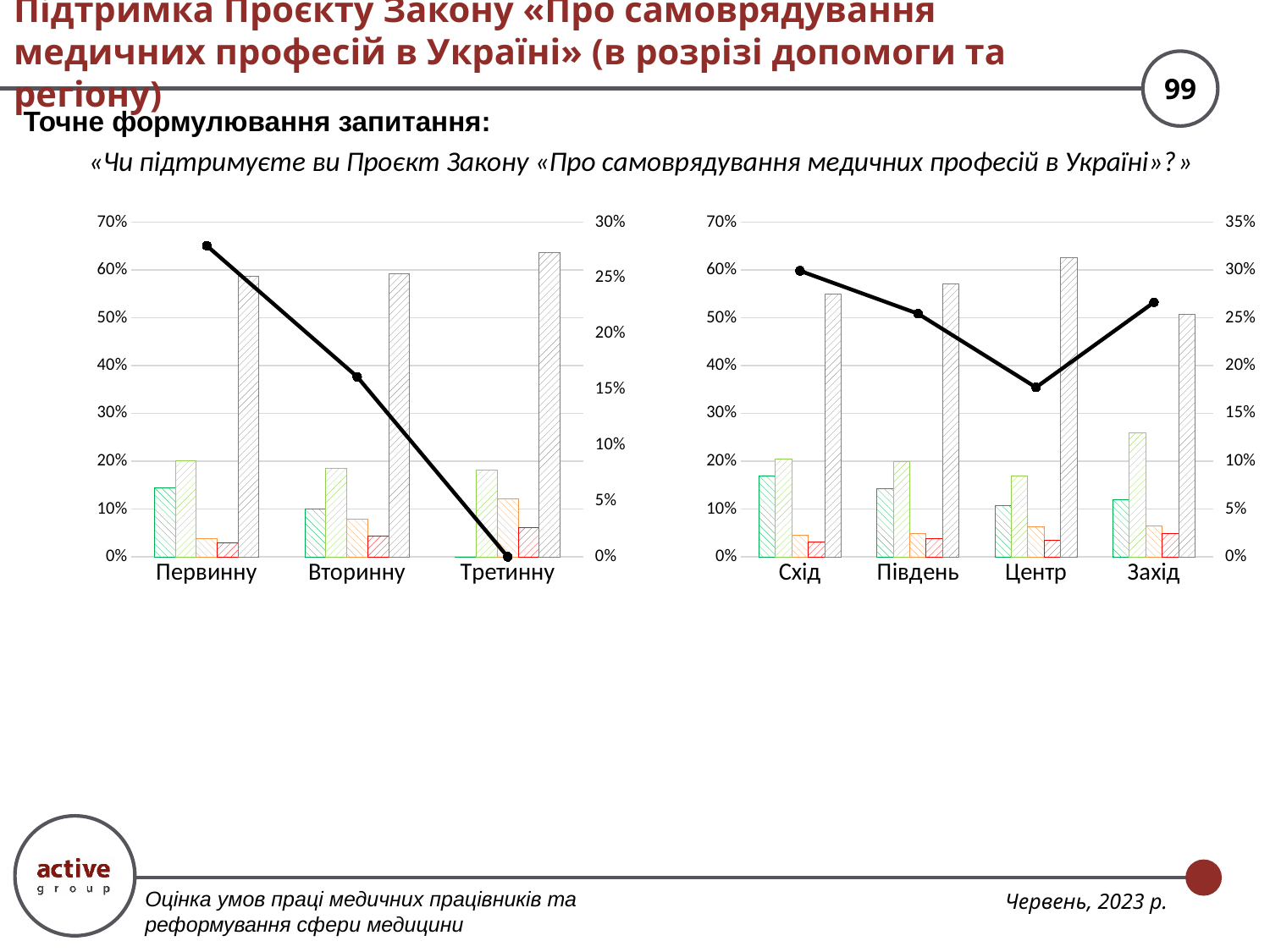
How many categories are shown on the x axis of the left chart? 3 In the right chart, is the tallest bar for Центр greater or less than 60%? greater What kind of chart is the left chart? Bar chart with a line In the left chart, which category has the tallest bar? Третинну In the right chart, which category has the tallest bar? Центр In the left chart, does the black line rise or fall from Первинну to Третинну? Falls How many categories are shown on the x axis of the right chart? 4 In the right chart, is the tallest bar for Схід greater or less than 60%? less In the right chart, at which category does the black line reach its lowest point? Центр In the left chart, is the tallest bar for Третинну greater or less than 60%? greater In the right chart, how does the black line move from Схід to Захід? Falls from Схід to Центр, then rises at Захід What kind of chart is the right chart? Bar chart with a line